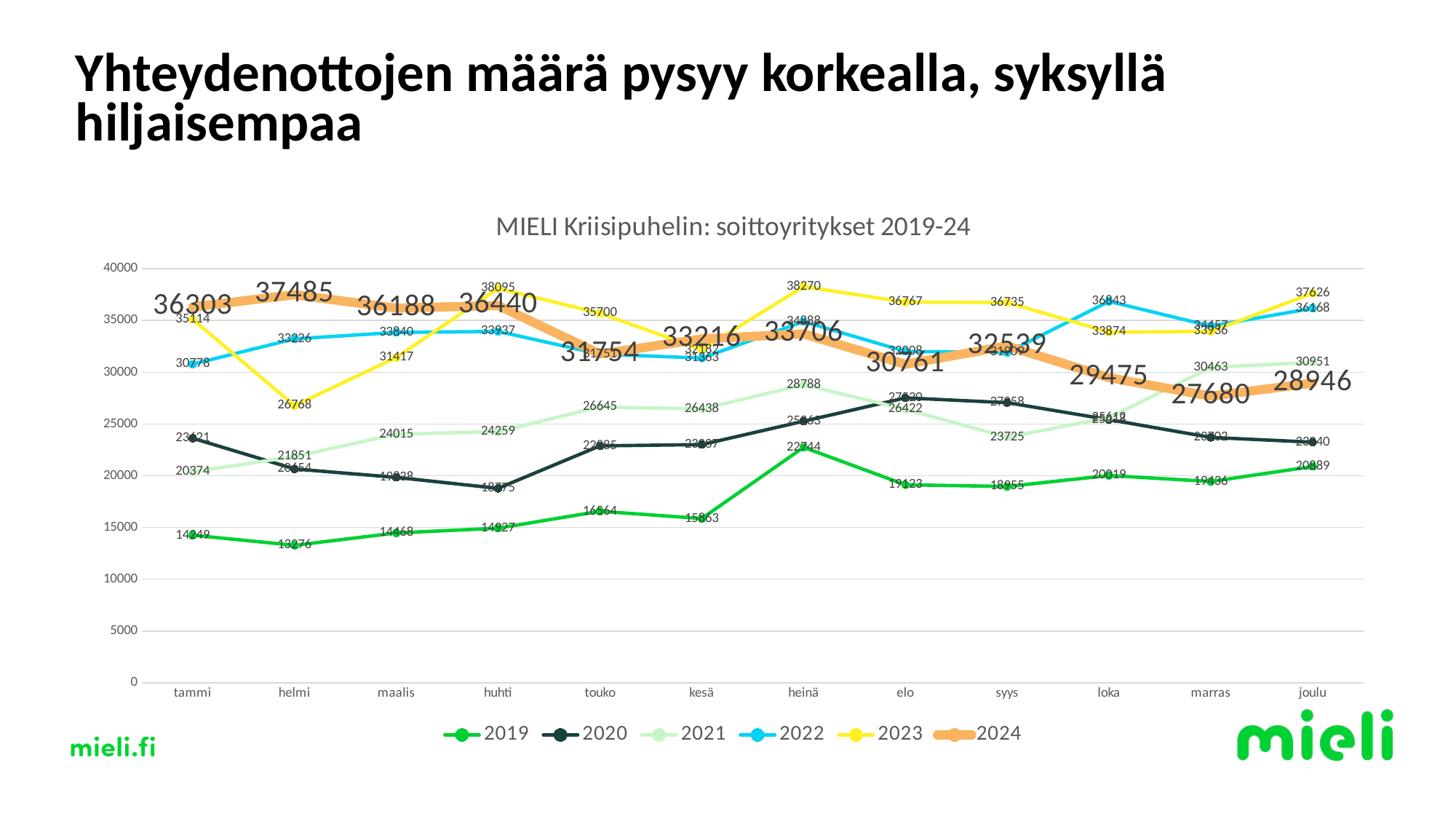
What kind of chart is shown on the slide? line chart What is the value for 2023 in heinä? 38270 How many months are shown on the x axis? 12 In which month does the 2024 series have its lowest value? marras What is the title of the chart? MIELI Kriisipuhelin: soittoyritykset 2019-24 For 2024, which month has the larger value, touko or kesä? kesä How many series does the legend list? 6 In which month does the 2024 series reach its highest value? helmi What is the value for 2024 in joulu? 28946 Is the value for 2019 in heinä greater or less than 20000? greater What is the difference between the 2024 values for helmi and tammi? 1182 What is the value for 2024 in helmi? 37485